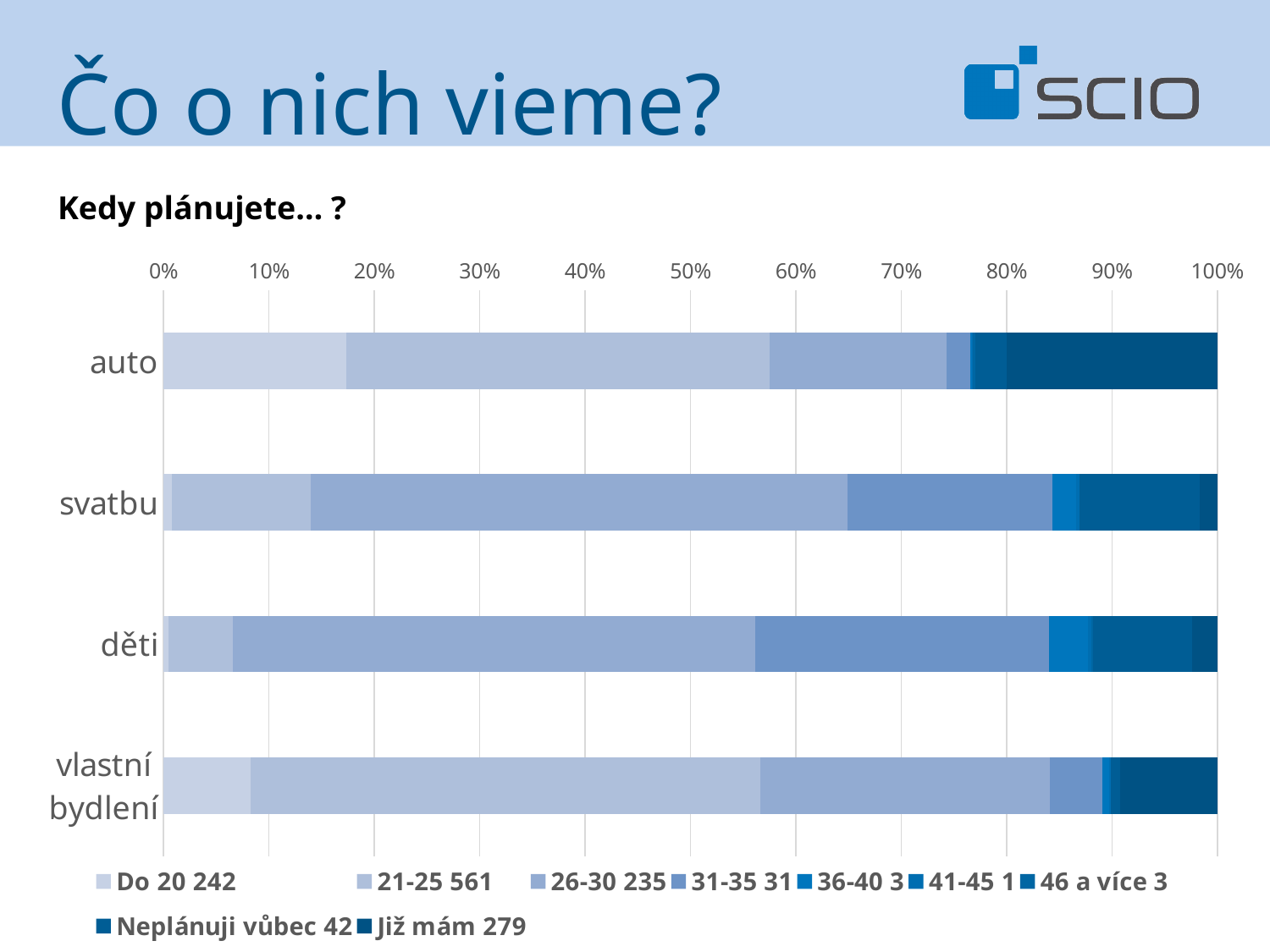
How many categories are plotted on the vertical axis of the chart? 4 How many series does the chart legend list? 9 Which category has the largest 'Do 20' segment? auto Is the 'Do 20' share for svatbu greater or less than 10%? less Which has a larger 'Do 20' segment, auto or děti? auto What is the question text shown above the chart? Kedy plánujete… ? What kind of chart is shown on the slide? bar chart Which category has the largest 'Již mám' segment? auto Is the 'Do 20' share for auto greater or less than 20%? less Is the 'Do 20' share for auto greater or less than 10%? greater What is the last entry in the chart legend? Již mám 279